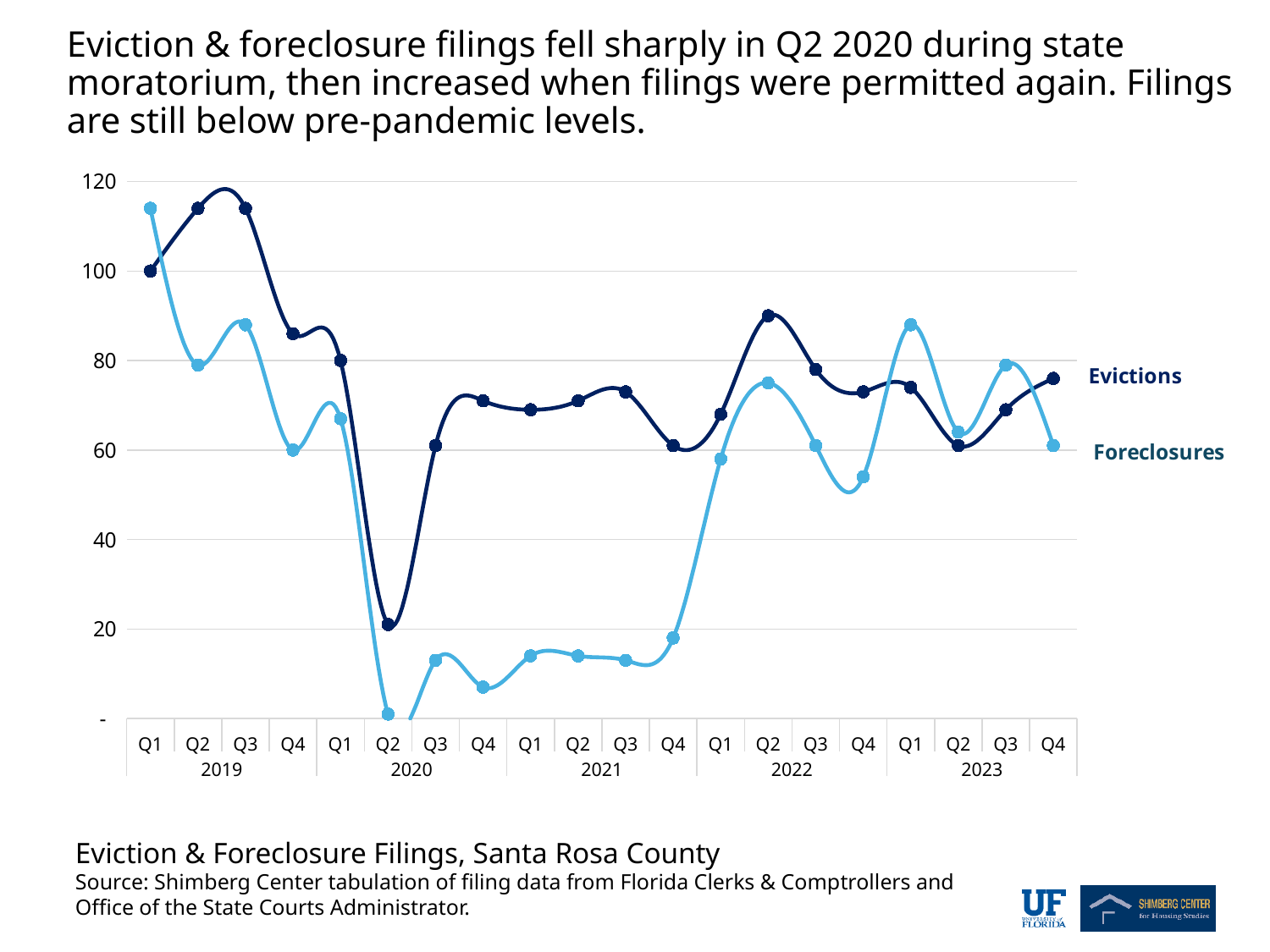
In which quarter is the Foreclosures line at its lowest? Q2 2020 In Q2 2020, which is larger, Evictions or Foreclosures? Evictions What kind of chart is shown on the slide? Line chart How many series does the chart show? 2 Is the value for Foreclosures in Q2 2022 greater or less than 60? greater What is the value for Foreclosures in Q4 2019? 60 In which quarter is the Foreclosures line at its highest? Q1 2019 How many quarterly data points does each line have? 20 Do Evictions rise or fall from Q3 2019 to Q2 2020? Fall Is the value for Evictions in Q2 2020 greater or less than 40? less What is the value for Evictions in Q1 2020? 80 What is the value for Evictions in Q1 2019? 100